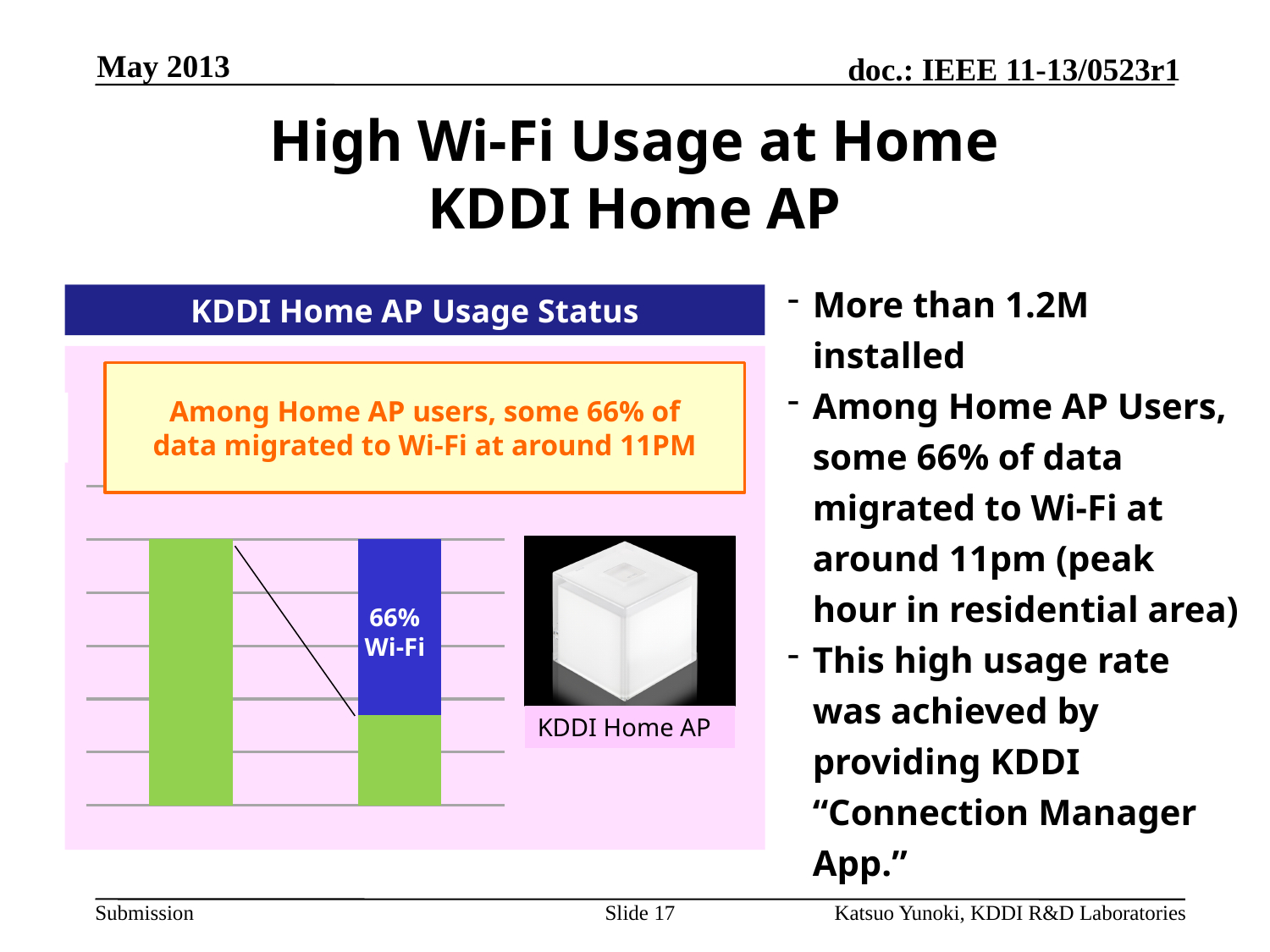
How many bars are plotted in the "KDDI Home AP Usage Status" chart? 2 In the "KDDI Home AP Usage Status" chart, what percentage is labelled on the blue segment of the right-hand bar? 66% What kind of chart is shown under the heading "KDDI Home AP Usage Status"? bar chart In the "KDDI Home AP Usage Status" chart, is the green portion of the right-hand bar larger or smaller than the green portion of the left-hand bar? smaller In the "KDDI Home AP Usage Status" chart, what share of the right-hand bar is labelled as Wi-Fi? 66% In the "KDDI Home AP Usage Status" chart, which bar is split into two segments, the left one or the right one? the right one In the "KDDI Home AP Usage Status" chart, what colour is the segment labelled "66% Wi-Fi"? blue